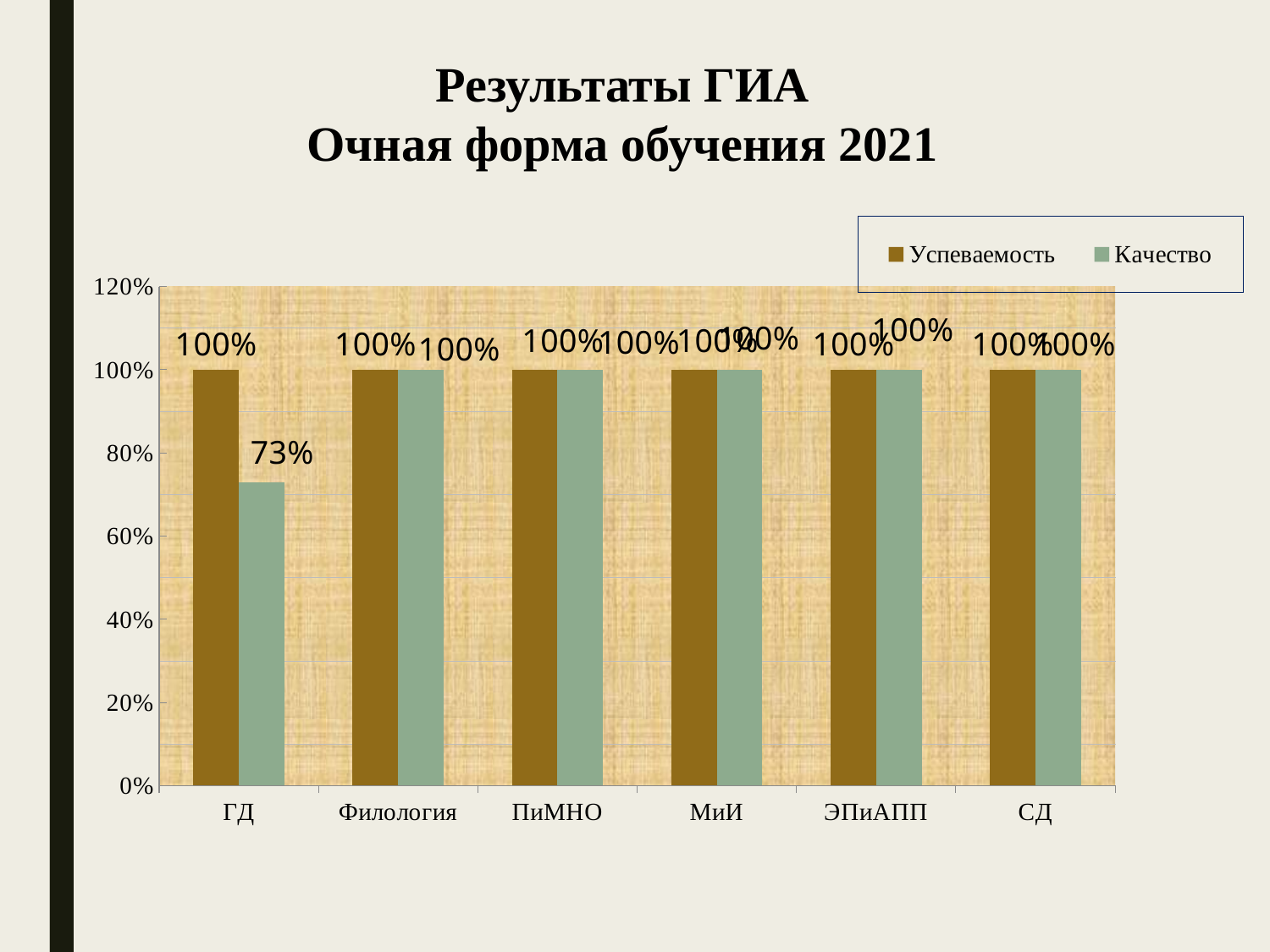
What is the Успеваемость value for ГД? 100% What kind of chart is shown on the slide? bar chart What is the Качество value for Филология? 100% What is the difference between the Успеваемость and Качество values for ГД? 27% How many series does the legend list? 2 What is the Качество value for ГД? 73% How many categories are shown on the x axis? 6 Is the Качество value for ГД greater or less than 80%? less Which series is shown in brown in the legend? Успеваемость What is the Успеваемость value for СД? 100% Which is larger for ГД: Успеваемость or Качество? Успеваемость Which category has the lowest Качество value? ГД